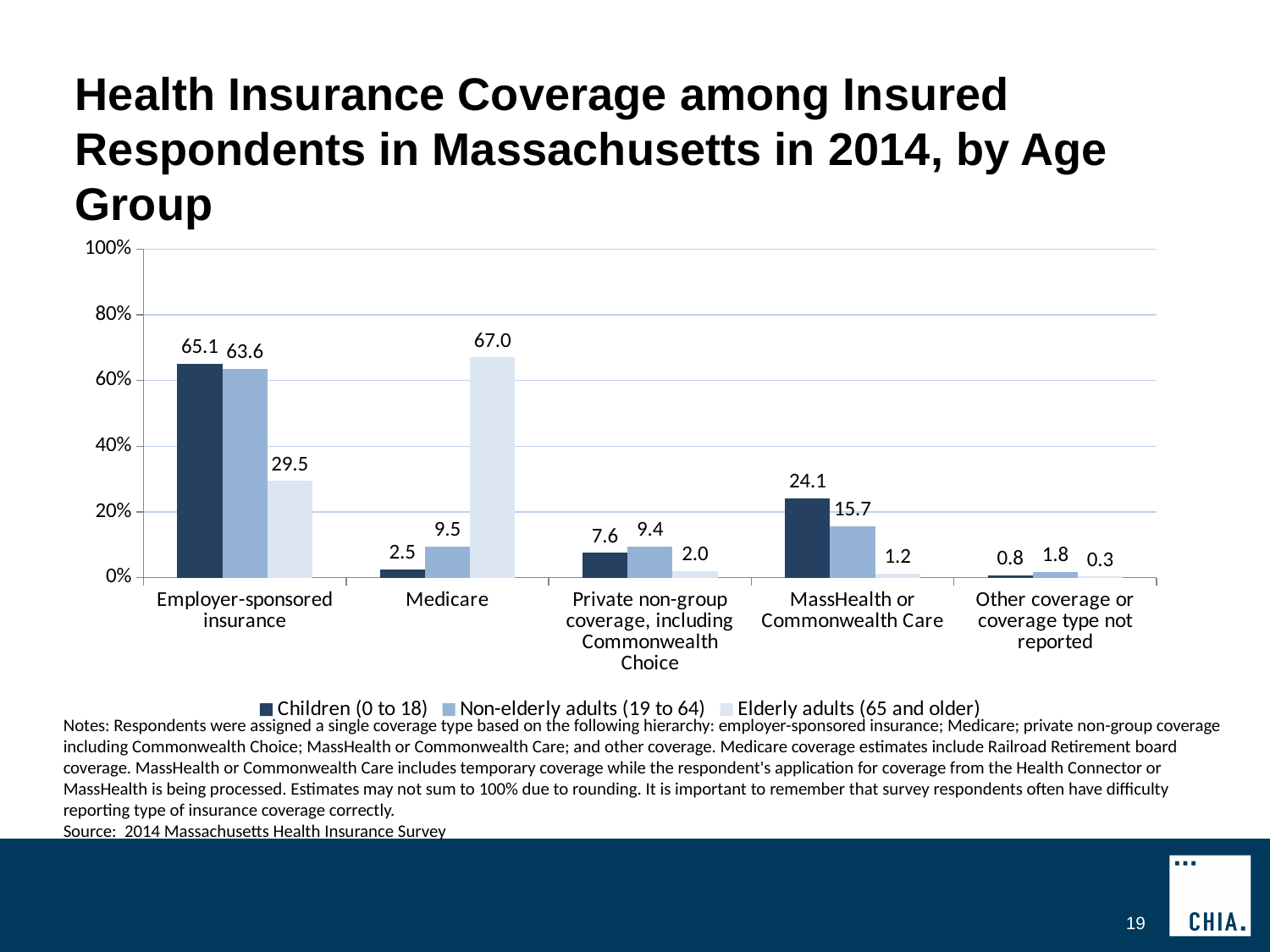
What is the value for Elderly adults (65 and older) in the Medicare category? 67.0 What kind of chart is shown on the slide? Bar chart Which category has the lowest value for Children (0 to 18)? Other coverage or coverage type not reported How many series does the legend list? 3 How many coverage categories are shown on the x axis? 5 Is the value for Elderly adults (65 and older) in the Employer-sponsored insurance category greater or less than 40%? less What is the difference between the Children (0 to 18) and Non-elderly adults (19 to 64) values in the MassHealth or Commonwealth Care category? 8.4 In the Medicare category, which is larger: the value for Children (0 to 18) or for Non-elderly adults (19 to 64)? Non-elderly adults (19 to 64) What is the source cited for the chart data? 2014 Massachusetts Health Insurance Survey Which category has the highest value for Elderly adults (65 and older)? Medicare What is the value for Non-elderly adults (19 to 64) in the MassHealth or Commonwealth Care category? 15.7 What is the value for Children (0 to 18) in the Employer-sponsored insurance category? 65.1